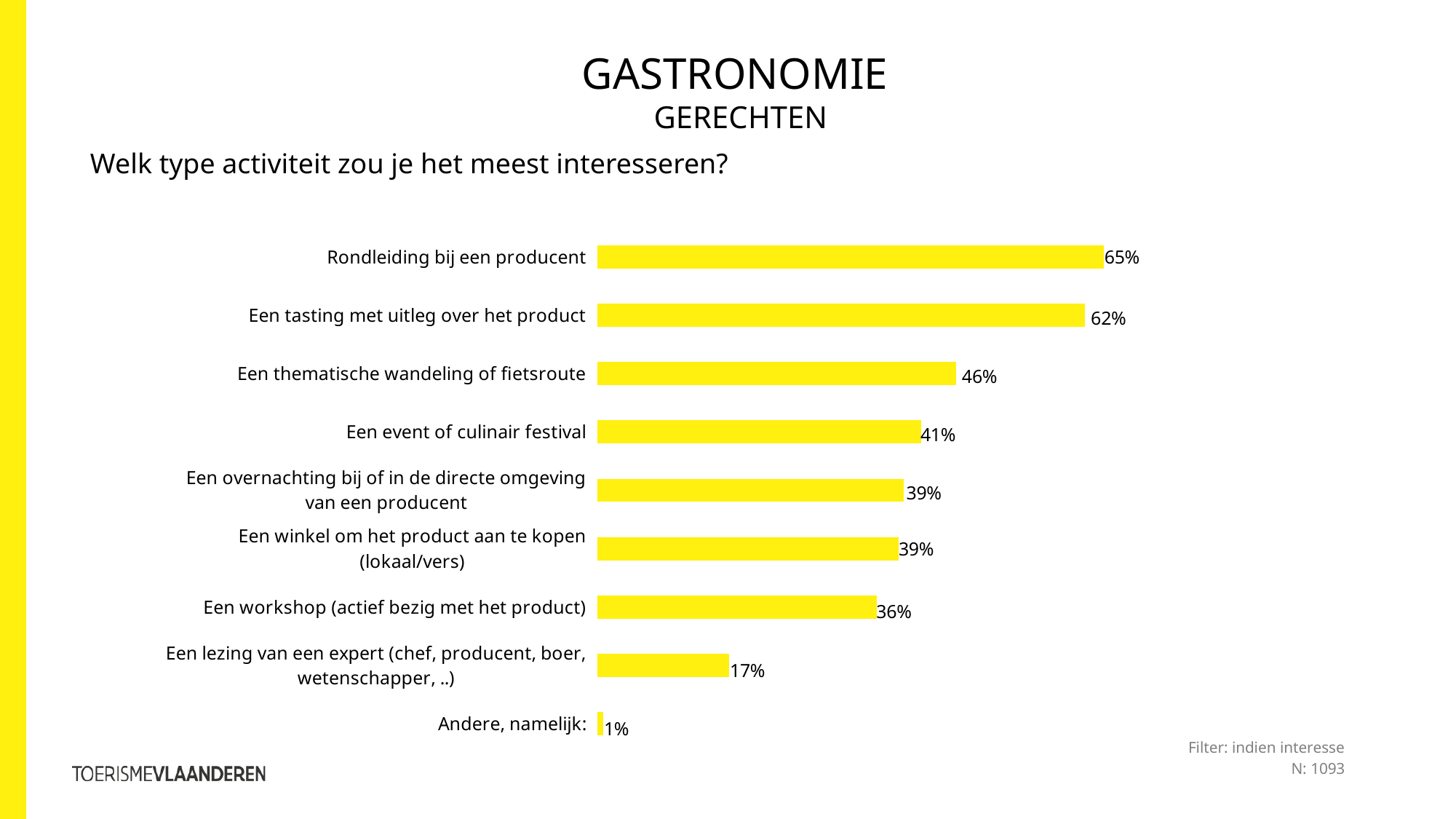
Which category has the highest value? Rondleiding bij een producent What question is the chart answering, as written above it? Welk type activiteit zou je het meest interesseren? What is the value for "Een thematische wandeling of fietsroute"? 46% What kind of chart is shown on the slide? Bar chart What is the value for "Een lezing van een expert (chef, producent, boer, wetenschapper, ..)"? 17% Which is larger: "Een thematische wandeling of fietsroute" or "Een event of culinair festival"? Een thematische wandeling of fietsroute Which category has the lowest value? Andere, namelijk: What is the difference between "Een event of culinair festival" and "Een lezing van een expert (chef, producent, boer, wetenschapper, ..)"? 24% What is the difference between "Rondleiding bij een producent" and "Een tasting met uitleg over het product"? 3% What is the value for "Een workshop (actief bezig met het product)"? 36% What is the value for "Rondleiding bij een producent"? 65% How many categories are shown in the chart? 9